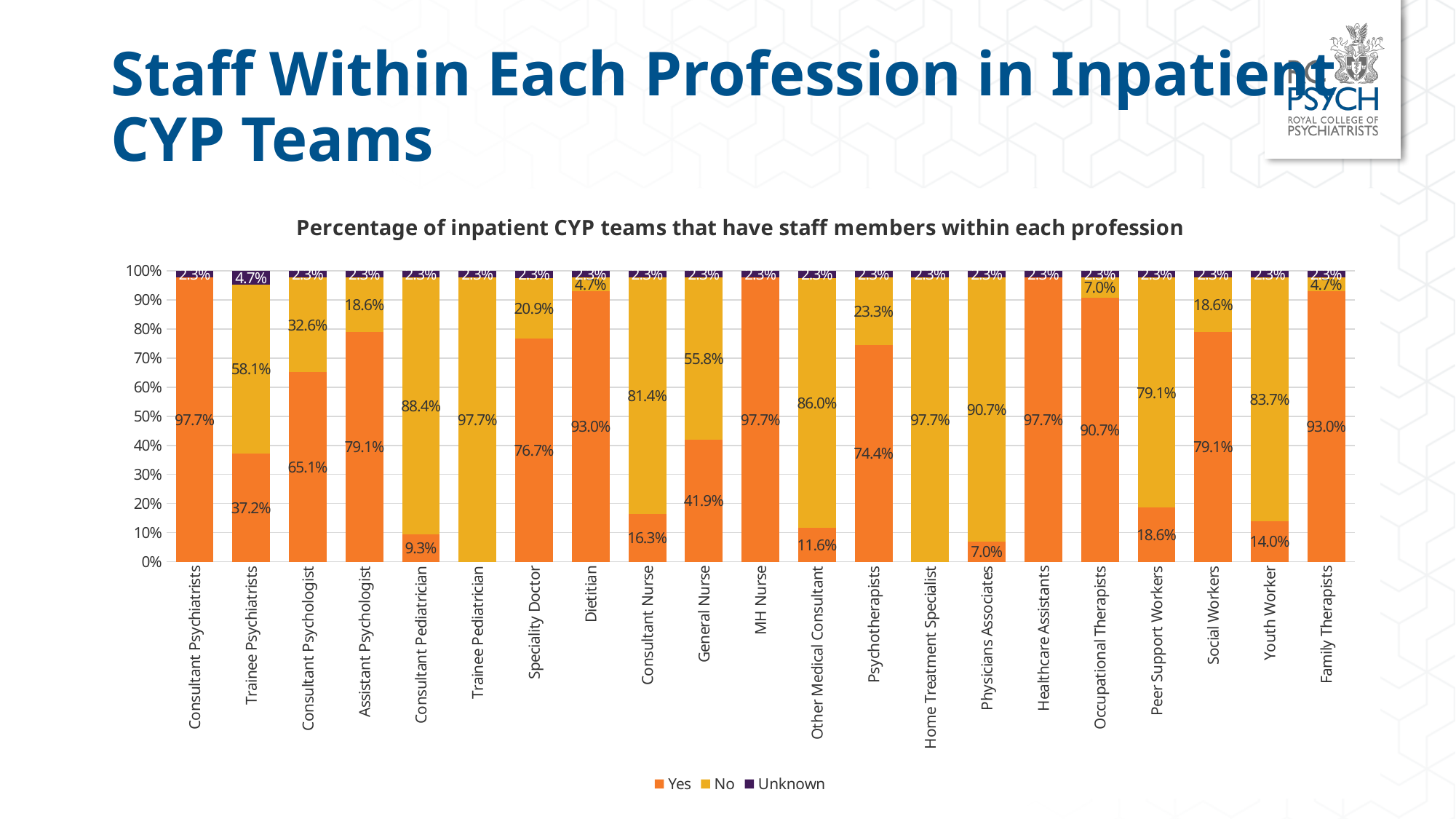
What is the total of the stacked bar for Trainee Psychiatrists? 100% How many professions are shown on the x axis? 21 What is the 'Unknown' value for Trainee Psychiatrists? 4.7% Which profession has the highest 'No' percentage? Trainee Pediatrician and Home Treatment Specialist (97.7%) What percentage of inpatient CYP teams answered 'Yes' for Consultant Psychologist? 65.1% Which profession has the lowest 'Yes' percentage? Trainee Pediatrician and Home Treatment Specialist (0%) How many series does the legend list? 3 What colour represents the 'No' series in the legend? Yellow What is the 'No' value for Consultant Pediatrician? 88.4% What is the difference between the 'Yes' values for Social Workers and Peer Support Workers? 60.5% Which has a larger 'Yes' value, General Nurse or Consultant Nurse? General Nurse What kind of chart is shown on the slide? Stacked bar chart